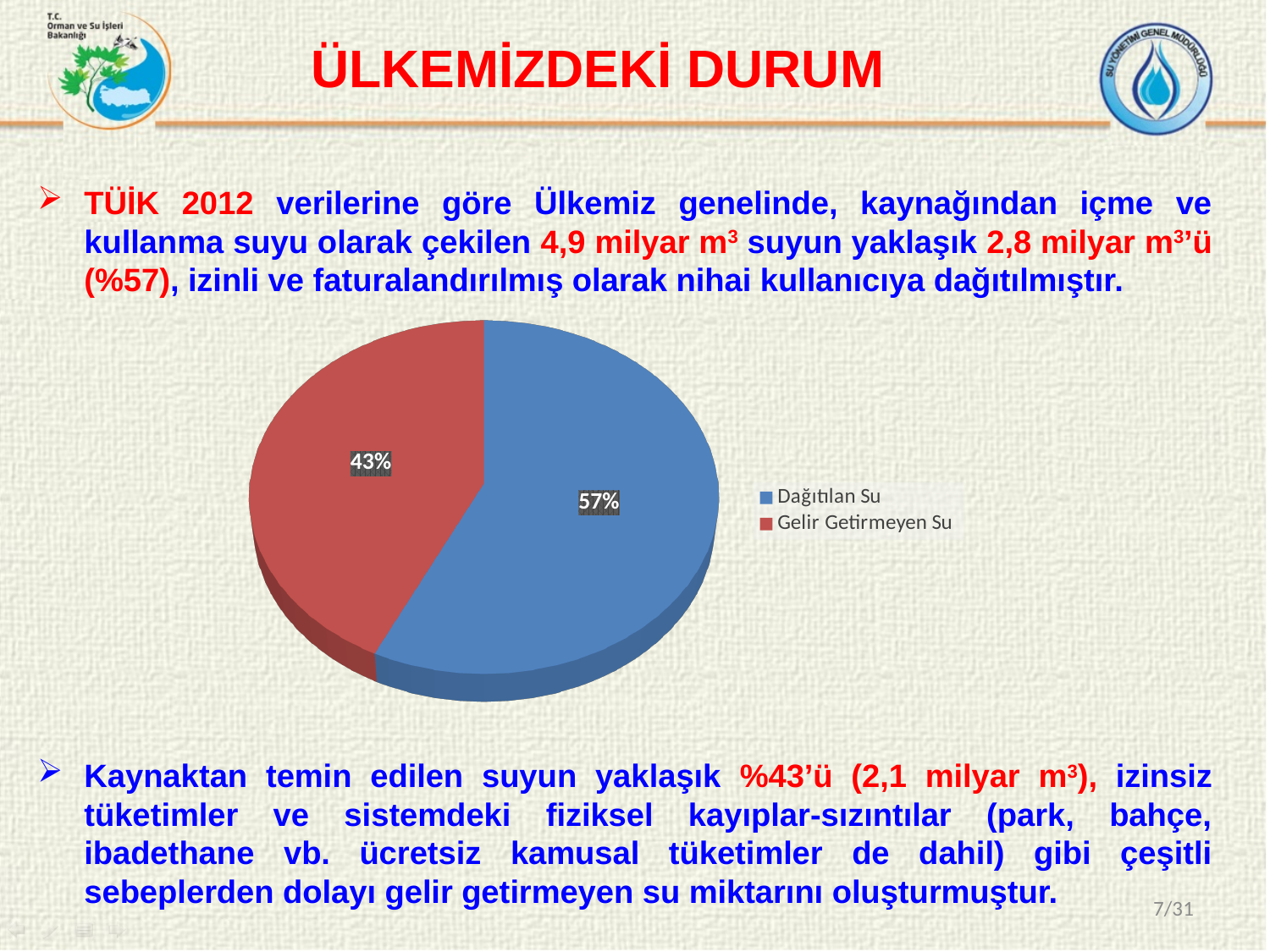
How many slices does the pie chart have? 2 Which slice of the pie is the smallest? Gelir Getirmeyen Su What share of the pie does Gelir Getirmeyen Su represent? 43% What share of the pie does Dağıtılan Su represent? 57% What is the difference in percentage points between the Dağıtılan Su and Gelir Getirmeyen Su slices? 14 How many entries does the legend list? 2 Is the share for Gelir Getirmeyen Su greater or less than 50%? less What colour is the Gelir Getirmeyen Su slice? Red What kind of chart is shown on the slide? Pie chart Which slice of the pie is the largest? Dağıtılan Su Which is larger, the Dağıtılan Su slice or the Gelir Getirmeyen Su slice? Dağıtılan Su What colour is the Dağıtılan Su slice? Blue